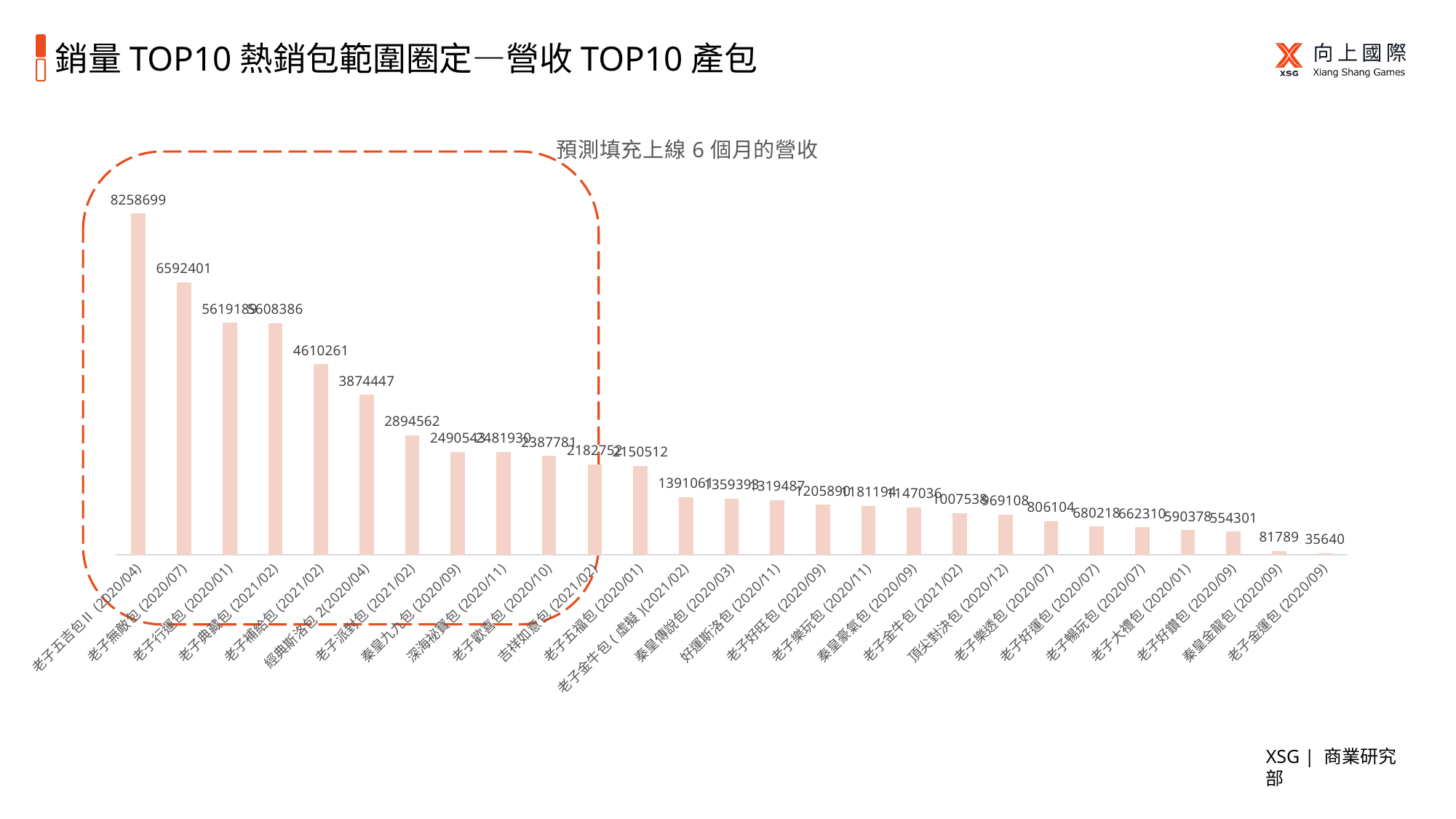
What is the value for 老子樂透包 (2020/07)? 806104 Which category has the lowest value? 老子金運包 (2020/09) Which category has the highest value? 老子五吉包II (2020/04) What is the value for 經典斯洛包2 (2020/04)? 3874447 What kind of chart is shown on the slide? bar chart What is the value for 老子五吉包II (2020/04)? 8258699 What is the value for 老子無敵包 (2020/07)? 6592401 How many categories (bars) are shown in the chart? 27 Do the values rise or fall from left to right along the x axis? fall What is the value for 老子金運包 (2020/09)? 35640 What is the difference between the values for 老子五吉包II (2020/04) and 老子無敵包 (2020/07)? 1666298 Which is larger, the value for 老子補給包 (2021/02) or 老子派對包 (2021/02)? 老子補給包 (2021/02)